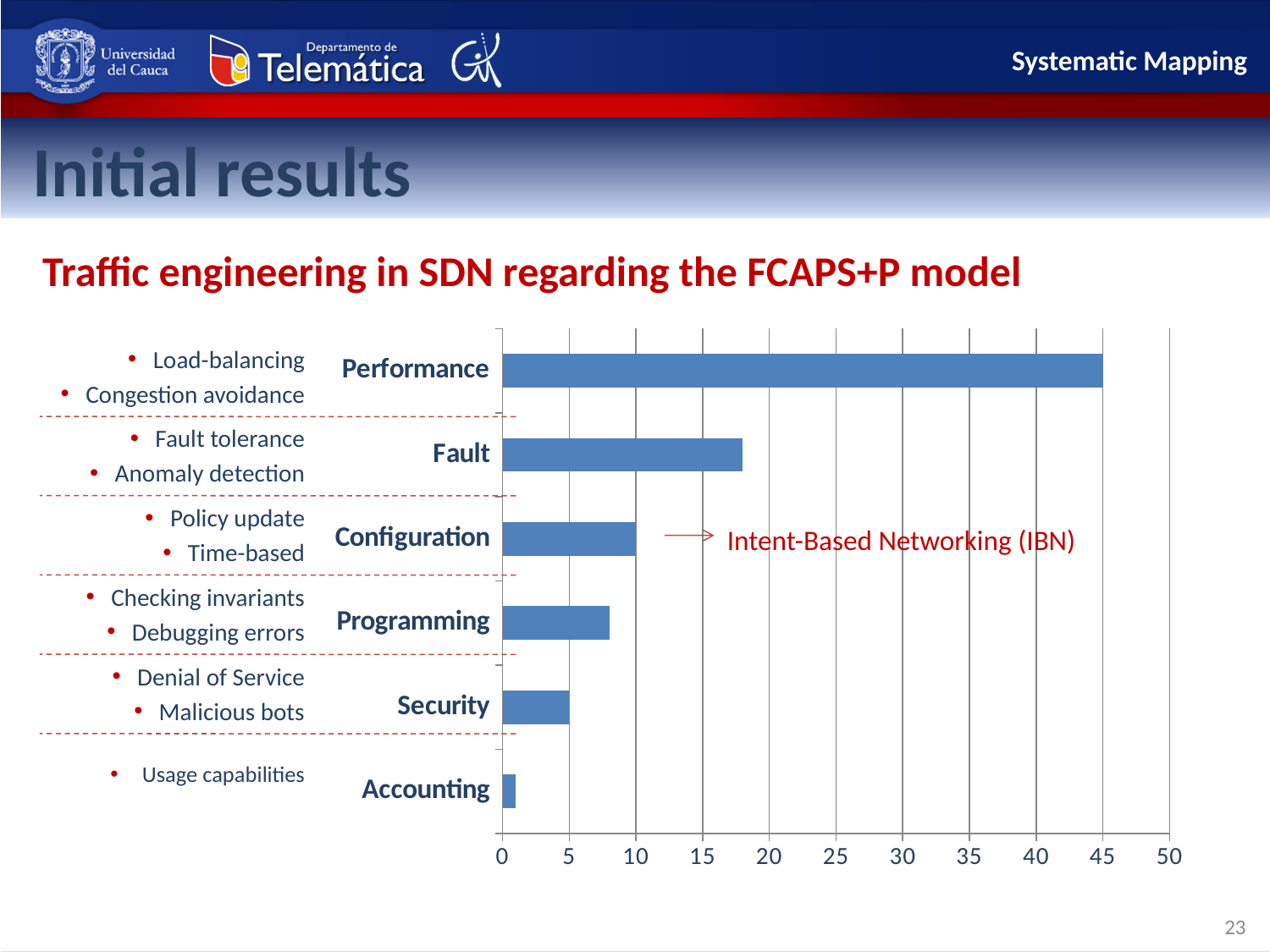
Which category has the lowest value? Accounting Which category has the highest value? Performance What is the difference between the values for Performance and Configuration? 35 Which is larger, the value for Fault or the value for Configuration? Fault What is the value for Security? 5 What is the value for Configuration? 10 How many categories are shown in the chart? 6 Is the value for Fault greater or less than 15? greater What kind of chart is shown on the slide? Bar chart Is the value for Accounting greater or less than 5? less Is the value for Programming greater or less than 10? less What is the value for Performance? 45